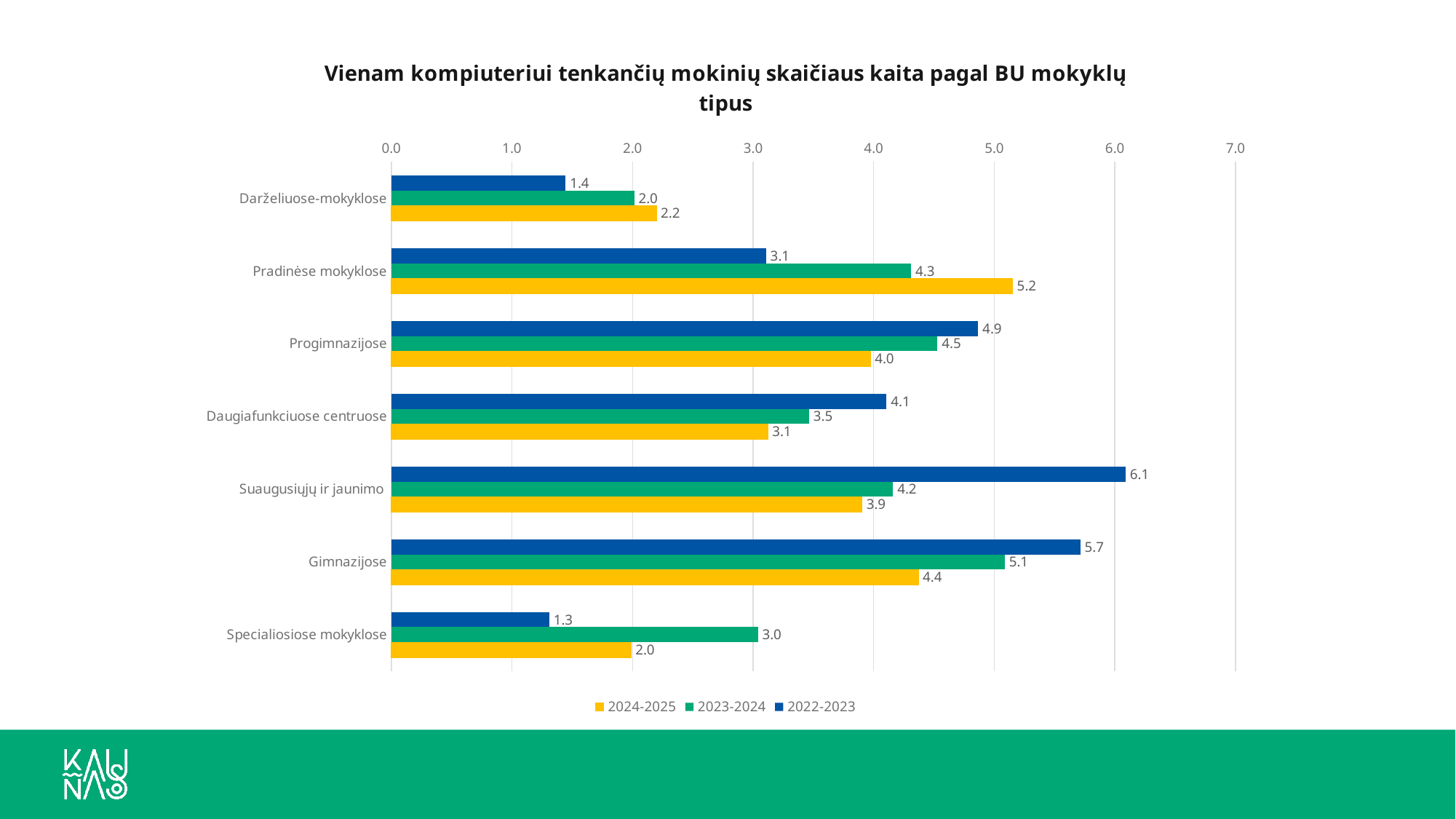
What is the value for Gimnazijose in the 2022-2023 series? 5.7 Which category has the highest value in the 2022-2023 series? Suaugusiųjų ir jaunimo What is the difference between the 2022-2023 and 2024-2025 values for Suaugusiųjų ir jaunimo? 2.2 What kind of chart is shown on the slide? bar chart Is the 2022-2023 value for Daugiafunkciuose centruose greater or less than 4.0? greater What is the value for Specialiosiose mokyklose in the 2023-2024 series? 3.0 What is the value for Pradinėse mokyklose in the 2024-2025 series? 5.2 How many school type categories are shown on the chart? 7 How many series does the legend list? 3 Which category has the lowest value in the 2024-2025 series? Specialiosiose mokyklose Which is larger for Progimnazijose: the 2023-2024 value or the 2024-2025 value? 2023-2024 Which colour represents the 2024-2025 series? yellow